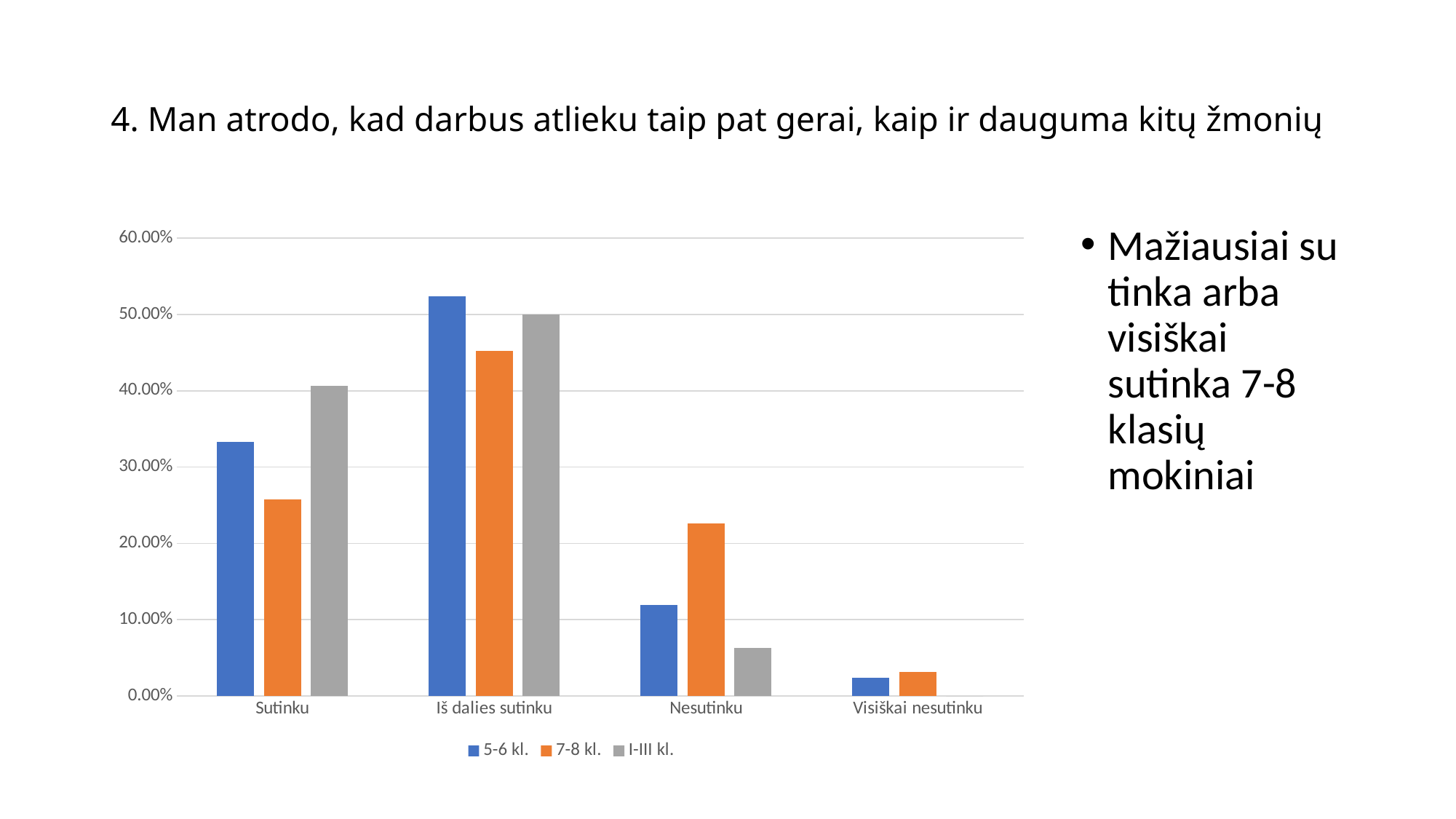
In the Nesutinku category, which series has the larger value: 7-8 kl. or 5-6 kl.? 7-8 kl. Is the value for I-III kl. in the Iš dalies sutinku category greater or less than 40.00%? greater How many series does the chart's legend list? 3 Is the value for 5-6 kl. in the Sutinku category greater or less than 30.00%? greater Is the value for I-III kl. in the Nesutinku category greater or less than 10.00%? less How many categories are shown on the x axis of the chart? 4 What kind of chart is shown on the slide? bar chart For the 5-6 kl. series, which category has the highest value? Iš dalies sutinku In the Sutinku category, which series has the larger value: I-III kl. or 7-8 kl.? I-III kl. Which series are listed in the chart's legend? 5-6 kl., 7-8 kl., I-III kl. For the 7-8 kl. series, which category has the lowest value? Visiškai nesutinku